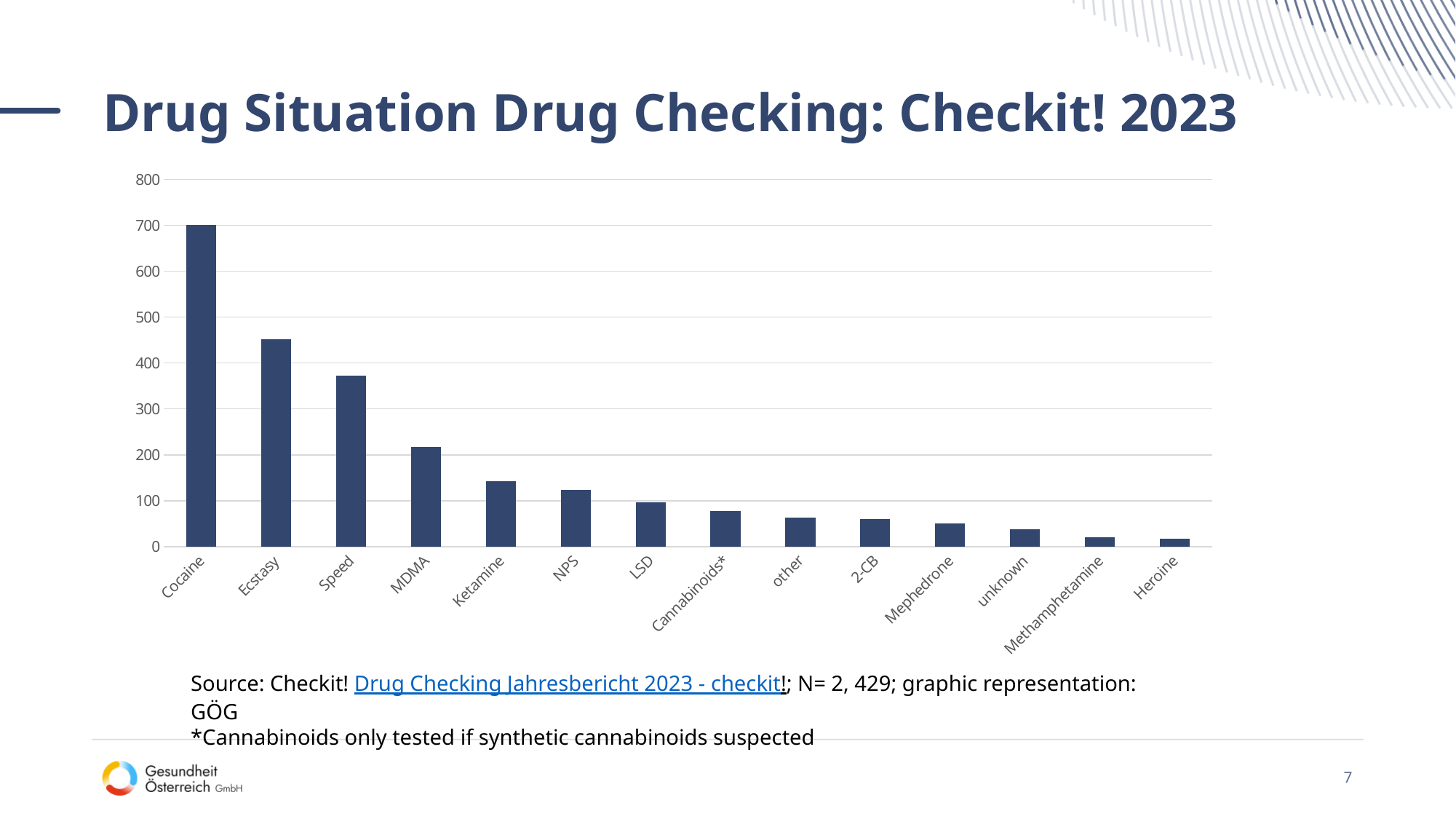
Is the value for Speed greater or less than 400? less Do the bar values rise or fall moving from left to right along the x axis? fall Is the value for Cocaine greater or less than 600? greater Which has a larger value, Ecstasy or Speed? Ecstasy Is the value for MDMA greater or less than 200? greater How many substance categories are shown on the x axis? 14 Which substance has the lowest bar in the chart? Heroine Which substance has the highest bar in the chart? Cocaine What is the title of the slide containing the chart? Drug Situation Drug Checking: Checkit! 2023 What kind of chart is shown on the slide? bar chart